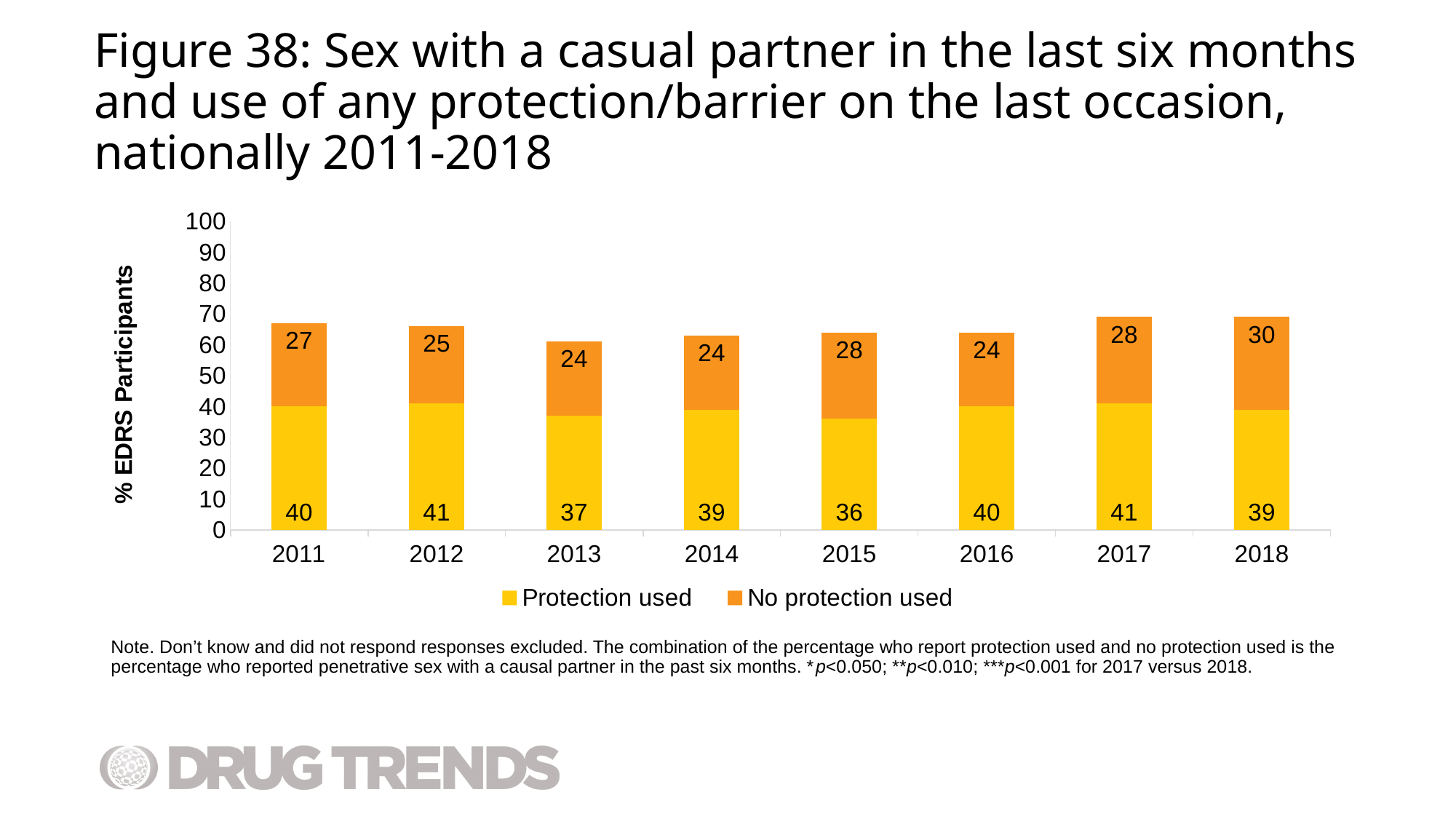
Which year has the highest value for 'No protection used'? 2018 What is the value for 'No protection used' in 2018? 30 What is the total of the stacked bar for 2017? 69 What is the difference between the 'Protection used' values for 2012 and 2015? 5 How many series does the legend list? 2 Which is larger: 'No protection used' in 2011 or 'No protection used' in 2013? 2011 Which year has the lowest value for 'Protection used'? 2015 What is the value for 'Protection used' in 2013? 37 What is the label of the y axis? % EDRS Participants How many years are shown on the x axis? 8 What kind of chart is shown on the slide? Stacked bar chart What is the total of the stacked bar for 2013? 61